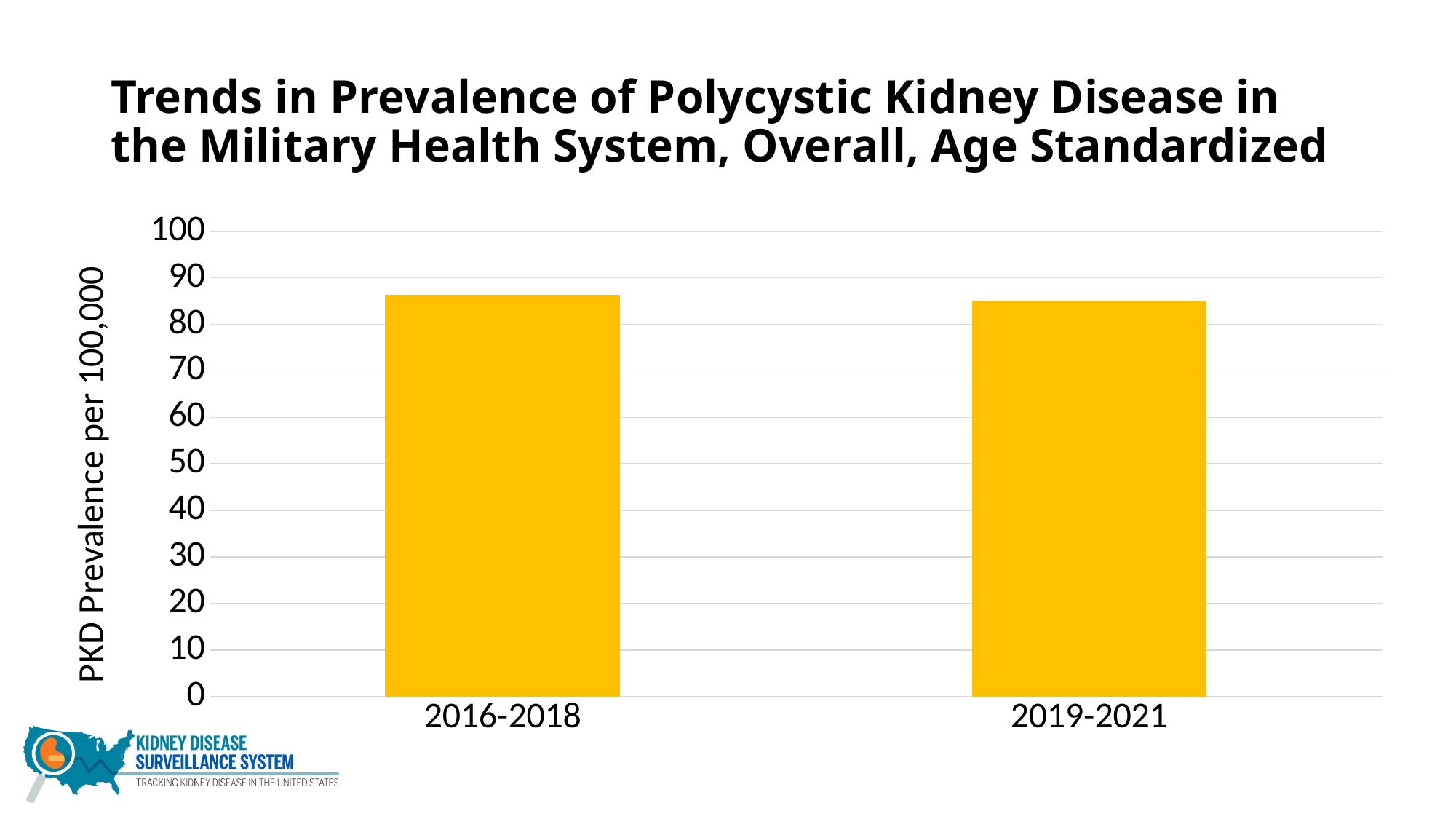
How many time periods are shown on the x axis of the chart? 2 Is the value for 2019-2021 greater or less than 80? greater Is the value for 2019-2021 greater or less than 50? greater Is the value for 2016-2018 greater or less than 80? greater What is the label on the y axis of the chart? PKD Prevalence per 100,000 What is the title of the chart? Trends in Prevalence of Polycystic Kidney Disease in the Military Health System, Overall, Age Standardized What kind of chart is shown on the slide? bar chart What is the highest value shown on the y axis of the chart? 100